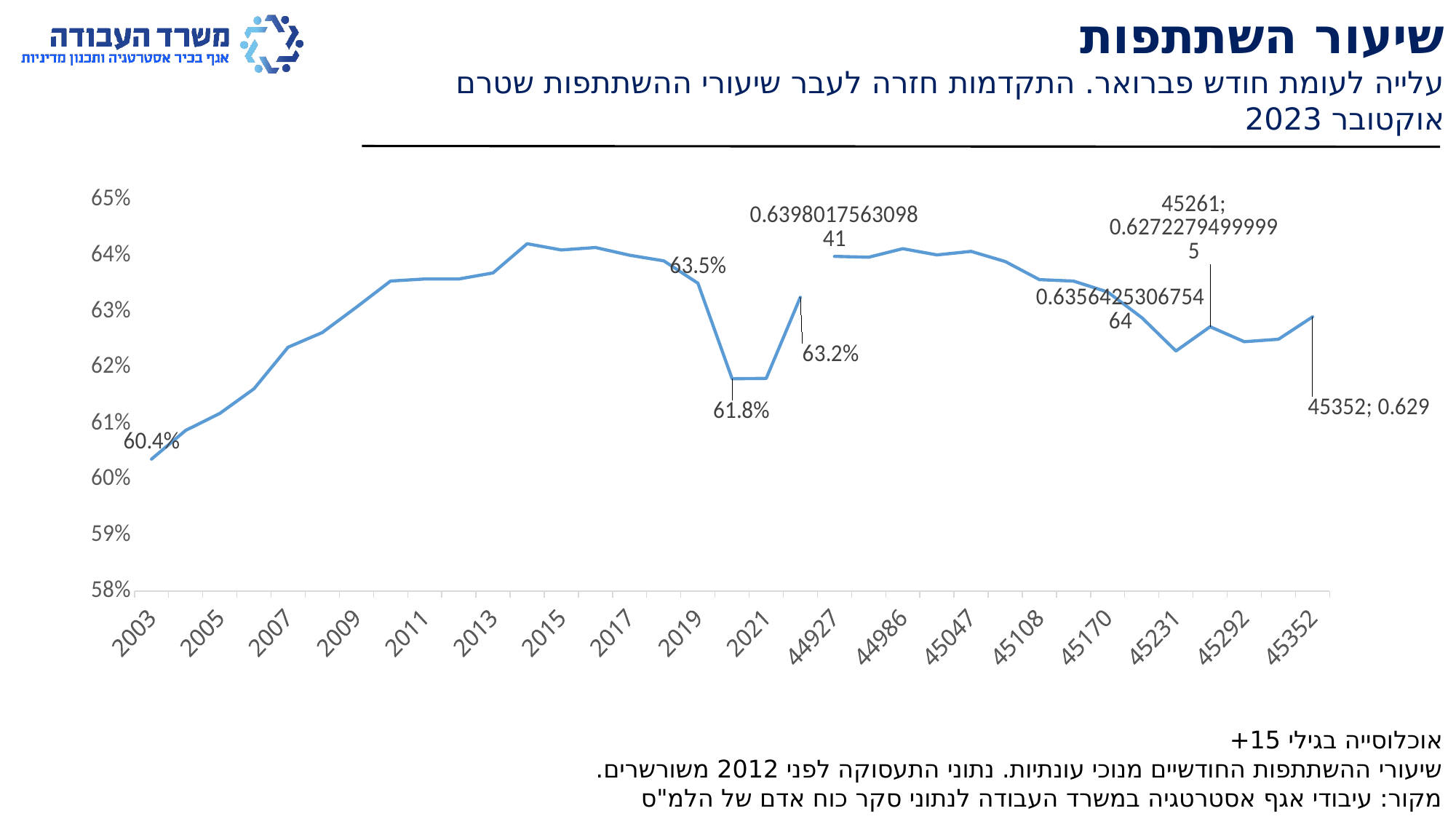
What is the participation rate shown for 2003? 60.4% What is the data label shown for the point at 45261? 45261; 0.627227949999995 Which x-axis category has the lowest value on the line? 2003 What kind of chart is shown on the slide? line chart What is the data label shown for the point at 44927? 0.639801756309841 Does the line rise or fall from 2003 to 2013? rises Is the value for 2011 greater or less than 64%? less What is the lowest value shown on the y-axis? 58% Is the value for 2003 greater or less than 61%? less By how many percentage points does the labeled 63.5% value exceed the labeled 61.8% value? 1.7 Is the value for 2009 greater or less than 62%? greater What is the data label shown at the last x-axis point, 45352? 45352; 0.629